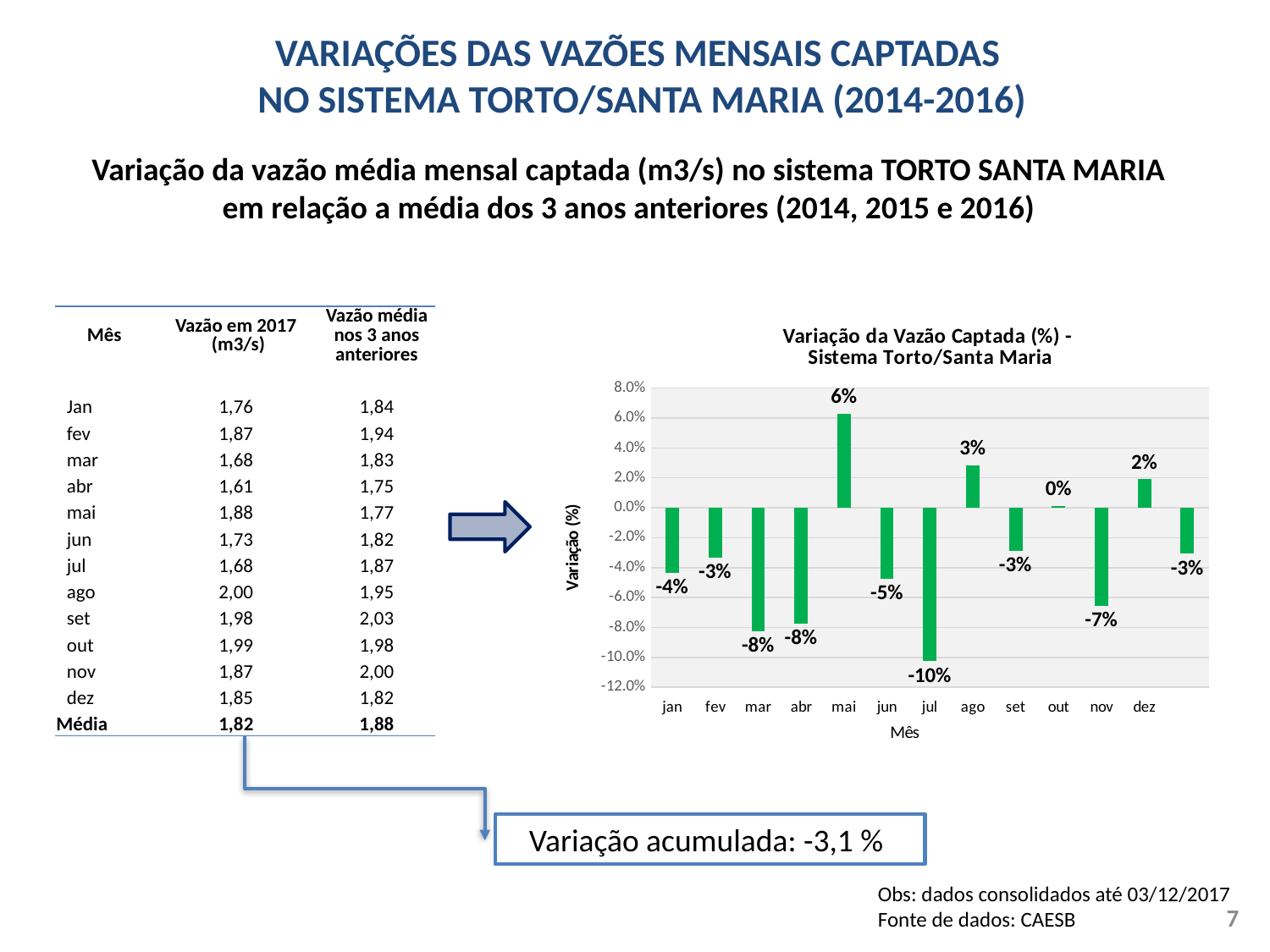
What is the value for jul in the chart? -10% What kind of chart is shown on the slide? bar chart Is the value for jul greater or less than -8.0%? less What is the value for nov in the chart? -7% What is the title of the chart? Variação da Vazão Captada (%) - Sistema Torto/Santa Maria Which month has the lowest value in the chart? jul What is the difference between the values for mai and ago? 3% How many months are shown on the x axis of the chart? 12 What is the value for mai in the chart? 6% What is the value for out in the chart? 0% Which is larger, the value for ago or the value for dez? ago Which month has the highest value in the chart? mai